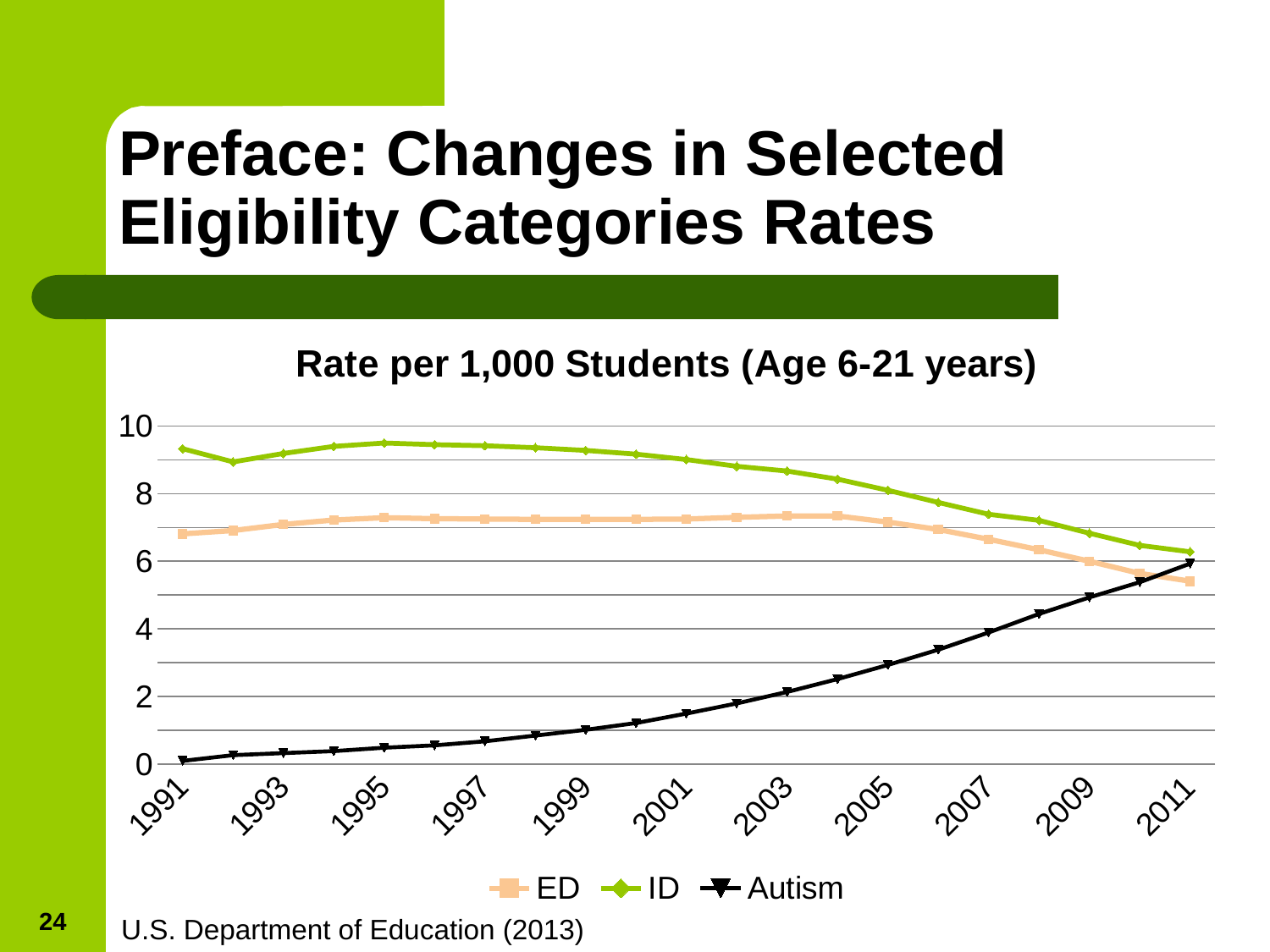
How many series does the legend list? 3 Does the Autism rate rise or fall from 1991 to 2011? rise Which series is drawn in green? ID Is the value for Autism in 2009 greater or less than 4? greater What kind of chart is shown on the slide? line chart Is the value for ID in 1991 greater or less than 8? greater Is the value for ED in 2011 greater or less than 6? less How many year labels are shown on the x axis? 11 In 2001, which series has the larger value, ED or Autism? ED Does the ID rate rise or fall from 1995 to 2011? fall What is the title of the chart? Rate per 1,000 Students (Age 6-21 years)